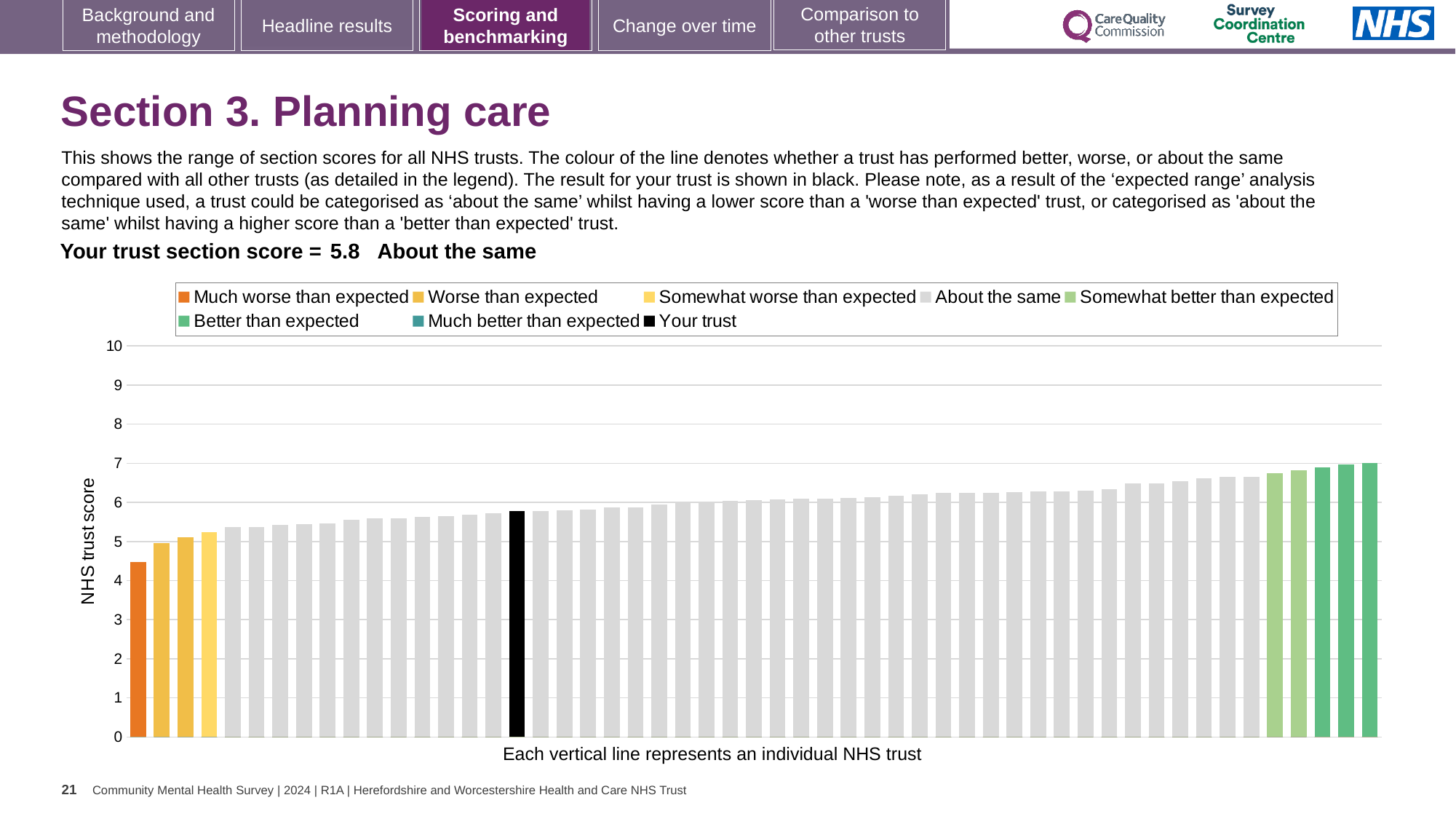
How many entries does the chart legend list? 8 What colour is the bar representing your trust? black What is the label on the vertical axis of the chart? NHS trust score Do the trust scores rise or fall moving from left to right along the x axis? rise What is the section score for your trust shown on the slide? 5.8 Is the value for your trust greater or less than 6? less Is the value for your trust greater or less than 5? greater What kind of chart is shown on the slide? bar chart Is the value of the highest-scoring trust (the rightmost bar) greater or less than 8? less Which is larger: the score for your trust or the score of the leftmost (orange) bar? your trust Which performance category is your trust placed in for this section? About the same